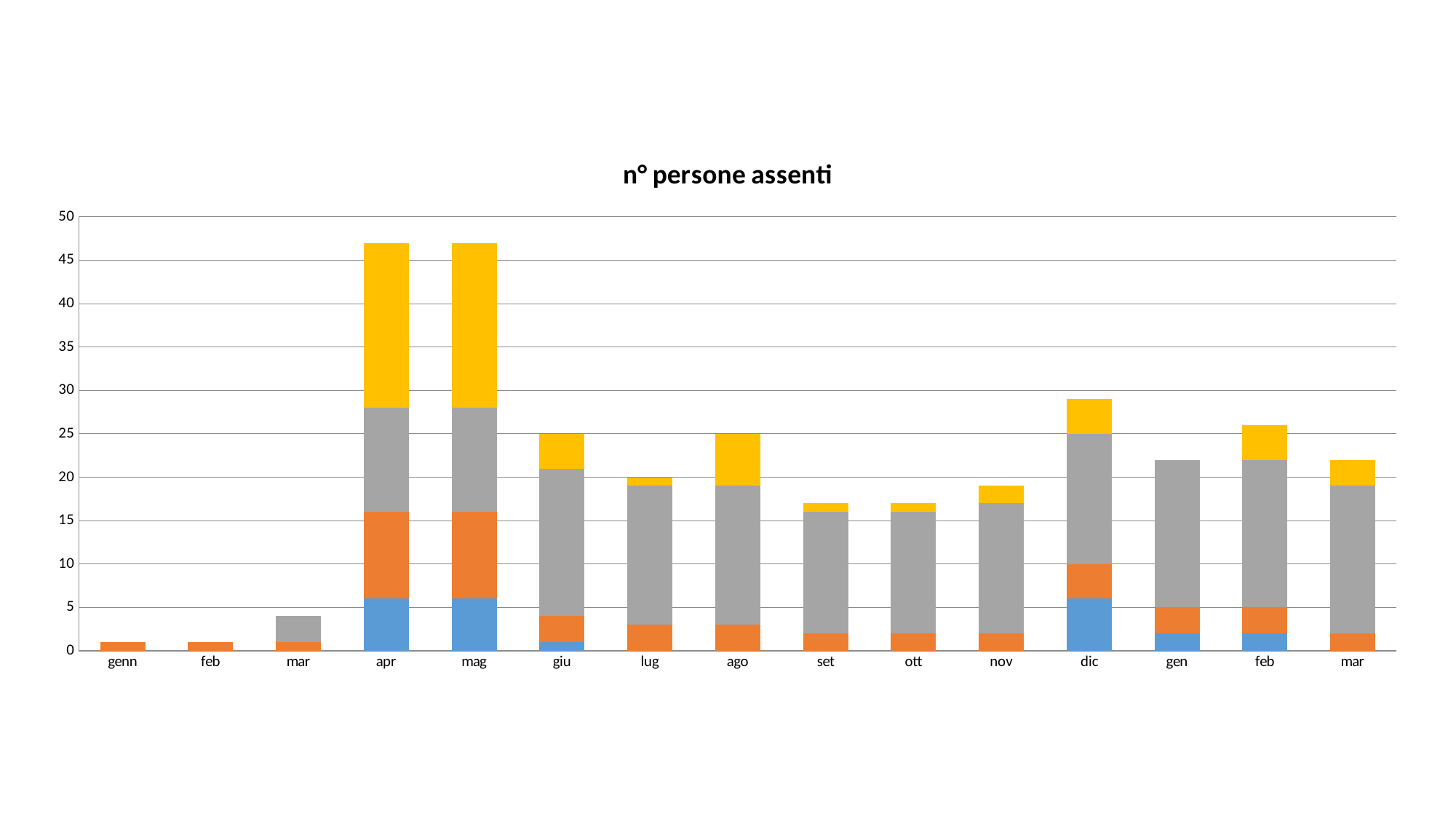
How many categories are shown on the x axis of the chart? 15 Is the total value of the bar for dic greater or less than 25? greater Is the total value of the bar for apr greater or less than 45? greater What kind of chart is shown on the slide? stacked bar chart How many different colours of segments are used in the stacked bars? 4 Is the total value of the bar for nov greater or less than 20? less What is the title of the chart? n° persone assenti Which bar is taller, apr or giu? apr Which bar is taller, dic or gen? dic Which bar is taller, genn or the first mar? mar